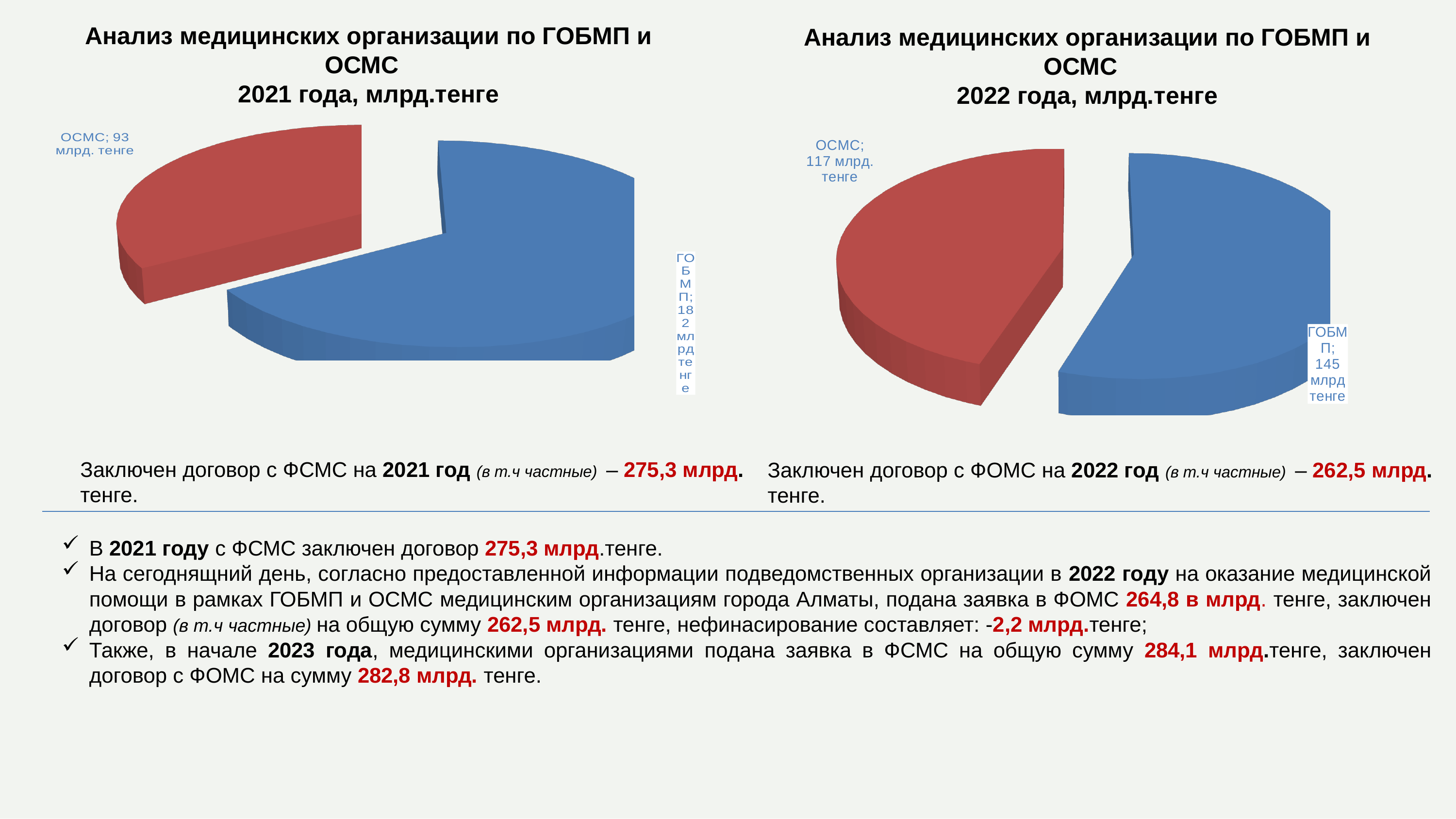
In the 2021 chart, what is the difference between ГОБМП and ОСМС? 89 млрд тенге In the 2022 chart, what is the difference between ГОБМП and ОСМС? 28 млрд тенге In the 2022 chart, what is the value for ГОБМП? 145 млрд тенге In the 2021 chart, what colour is the ОСМС slice? Red In the 2021 chart, what is the value for ОСМС? 93 млрд. тенге In the 2022 chart, which slice is the smallest? ОСМС Is the ОСМС value larger in the 2021 chart or the 2022 chart? 2022 What type of chart is used on the left side of the slide? Pie chart In the 2021 chart, what is the value for ГОБМП? 182 млрд тенге In the 2022 chart, what is the value for ОСМС? 117 млрд. тенге How many slices does the 2022 chart have? 2 In the 2021 chart, which slice is the largest? ГОБМП